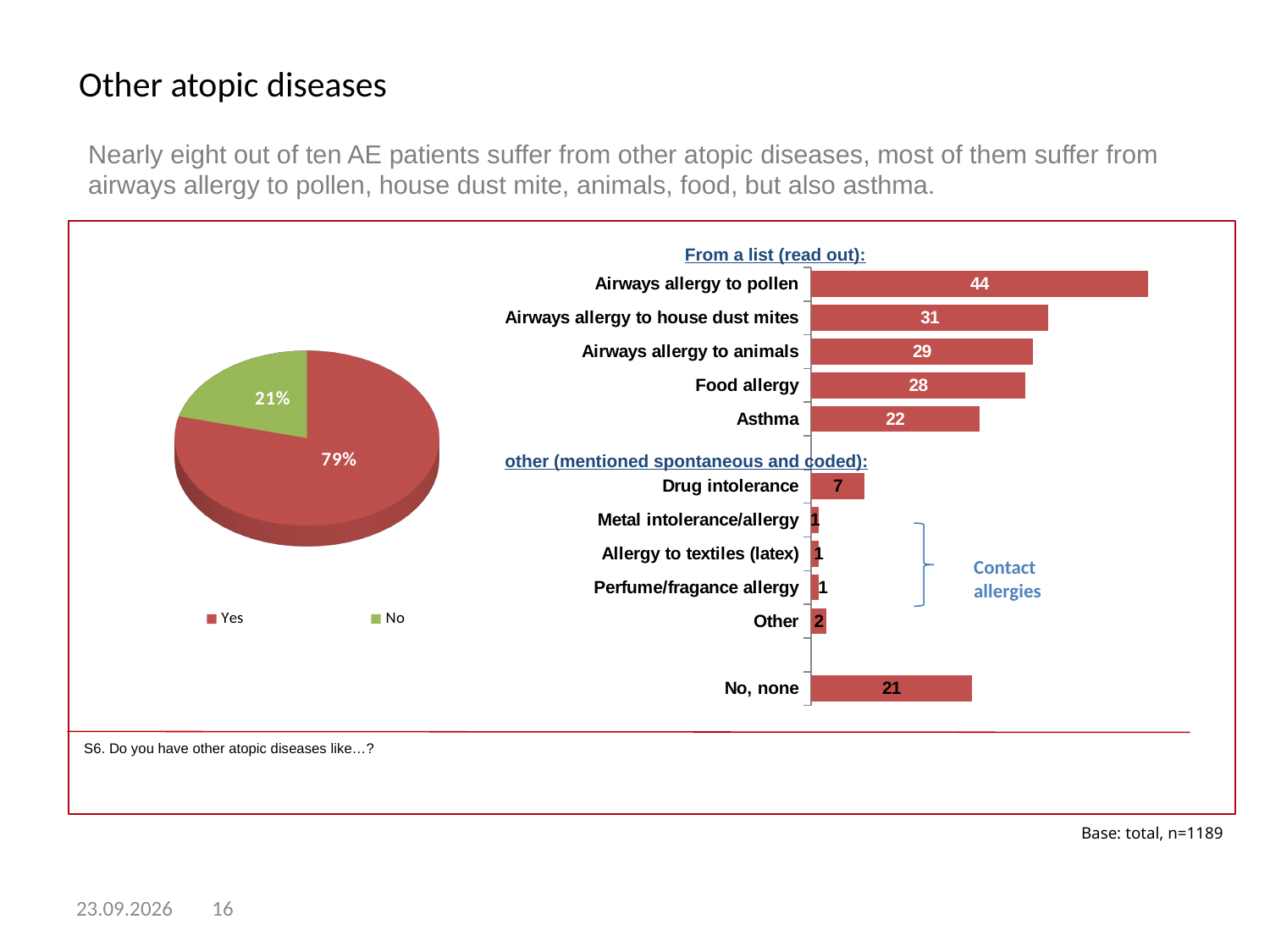
In the bar chart on the right, which is larger: Drug intolerance or No, none? No, none In the pie chart on the left, what share of patients answered No? 21% What kind of chart is the chart on the left of the slide? Pie chart In the bar chart on the right, what is the value for Asthma? 22 In the bar chart on the right, what is the value for Airways allergy to pollen? 44 In the bar chart on the right, what is the difference between Airways allergy to house dust mites and Food allergy? 3 In the bar chart on the right, which category has the highest value? Airways allergy to pollen What kind of chart is the chart on the right of the slide? Bar chart In the pie chart on the left, what share of patients answered Yes? 79% How many entries does the legend of the pie chart on the left list? 2 How many categories are plotted in the bar chart on the right? 11 In the bar chart on the right, what is the value for Other? 2